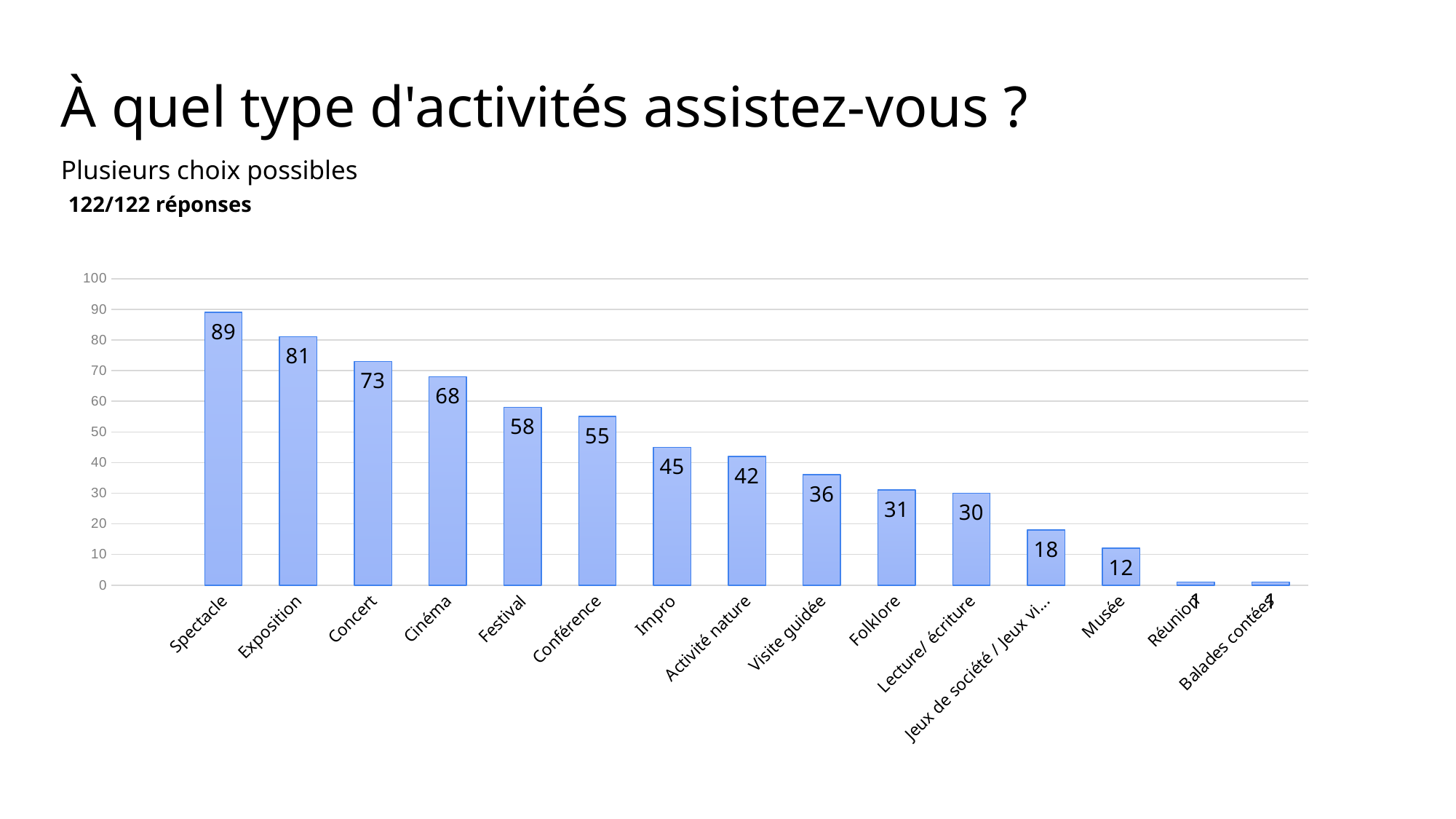
What is the value for Musée? 12 What is the value for Concert? 73 What type of chart is shown on the slide? bar chart What is the value for Visite guidée? 36 Is the value for Festival greater or less than 50? greater How many categories are shown on the x axis? 15 Which category has the highest value? Spectacle Do the values rise or fall from left to right along the x axis? fall What is the difference between the values for Exposition and Cinéma? 13 Which has a larger value, Impro or Folklore? Impro What is the value for Spectacle? 89 What is the value for Conférence? 55